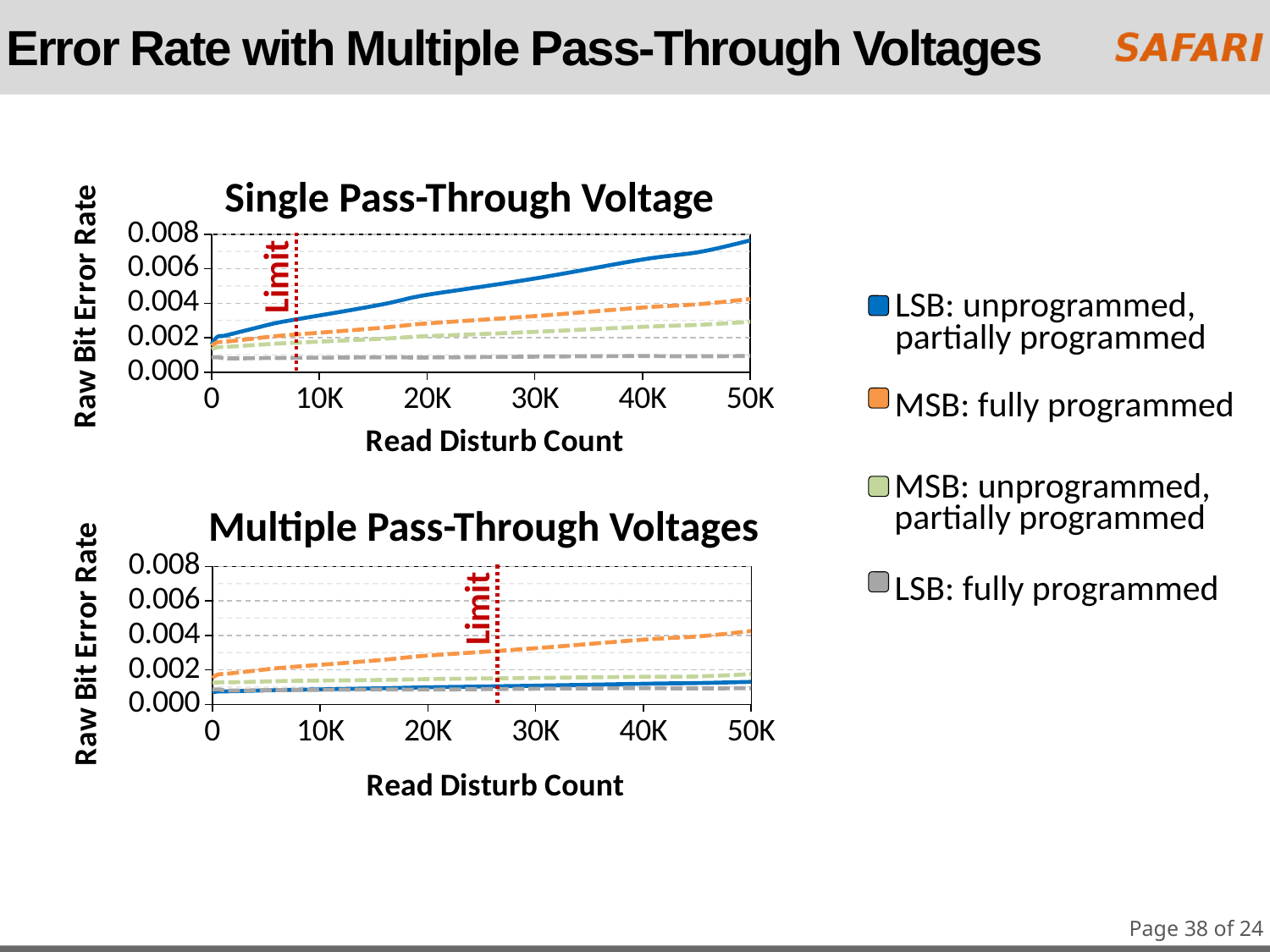
In the "Single Pass-Through Voltage" chart, which series has the highest raw bit error rate at a read disturb count of 50K? LSB: unprogrammed, partially programmed In the "Multiple Pass-Through Voltages" chart, is the dotted "Limit" line located at a read disturb count greater or less than 20K? greater In the "Multiple Pass-Through Voltages" chart, which series has the highest raw bit error rate at a read disturb count of 50K? MSB: fully programmed In the "Single Pass-Through Voltage" chart, at a read disturb count of 50K, which series has the larger raw bit error rate: "LSB: unprogrammed, partially programmed" or "MSB: fully programmed"? LSB: unprogrammed, partially programmed In the "Single Pass-Through Voltage" chart, is the raw bit error rate of the "LSB: unprogrammed, partially programmed" series at 50K greater or less than 0.006? greater In the "Single Pass-Through Voltage" chart, which series has the lowest raw bit error rate at a read disturb count of 50K? LSB: fully programmed In the "Multiple Pass-Through Voltages" chart, is the raw bit error rate of the "MSB: fully programmed" series at 50K greater or less than 0.002? greater In the "Multiple Pass-Through Voltages" chart, is the raw bit error rate of the "LSB: unprogrammed, partially programmed" series at 50K greater or less than 0.002? less What type of chart is the "Single Pass-Through Voltage" chart? line chart How many series does the legend list for the charts on this slide? 4 In the "Single Pass-Through Voltage" chart, does the raw bit error rate of the "LSB: unprogrammed, partially programmed" series rise or fall as the read disturb count increases? rise What is the x-axis title of the "Multiple Pass-Through Voltages" chart? Read Disturb Count